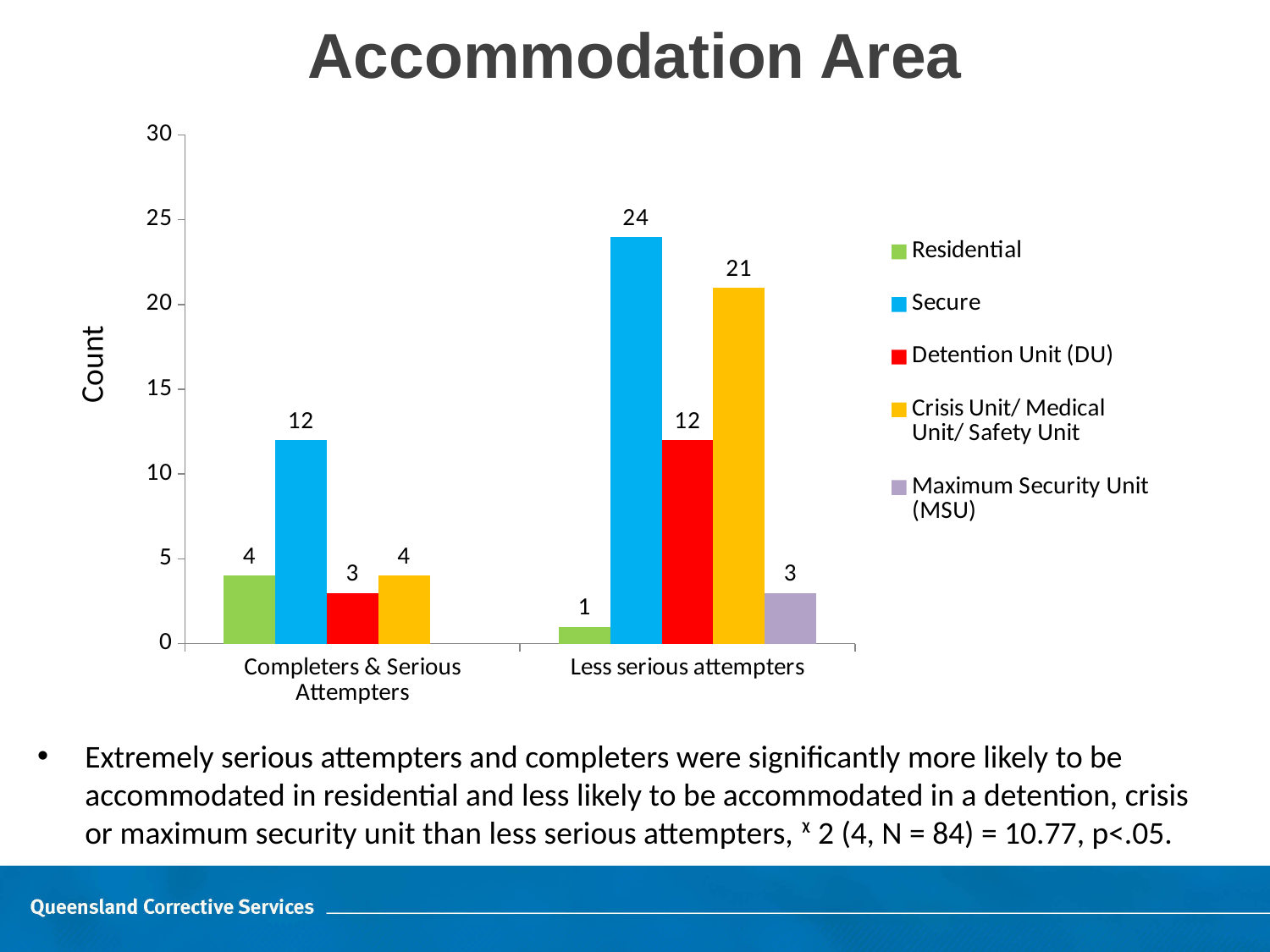
What kind of chart is shown on the slide? Bar chart What is the Residential count for Completers & Serious Attempters? 4 What is the label of the y axis? Count What is the difference between the Secure counts for Less serious attempters and Completers & Serious Attempters? 12 Which group has the larger Residential count, Completers & Serious Attempters or Less serious attempters? Completers & Serious Attempters What is the Crisis Unit/ Medical Unit/ Safety Unit count for Less serious attempters? 21 Which accommodation area has the lowest count for Less serious attempters? Residential How many series does the legend list? 5 What is the Secure count for Less serious attempters? 24 Which accommodation area has the highest count for Less serious attempters? Secure How many categories are shown on the x axis? 2 What is the Maximum Security Unit (MSU) count for Less serious attempters? 3